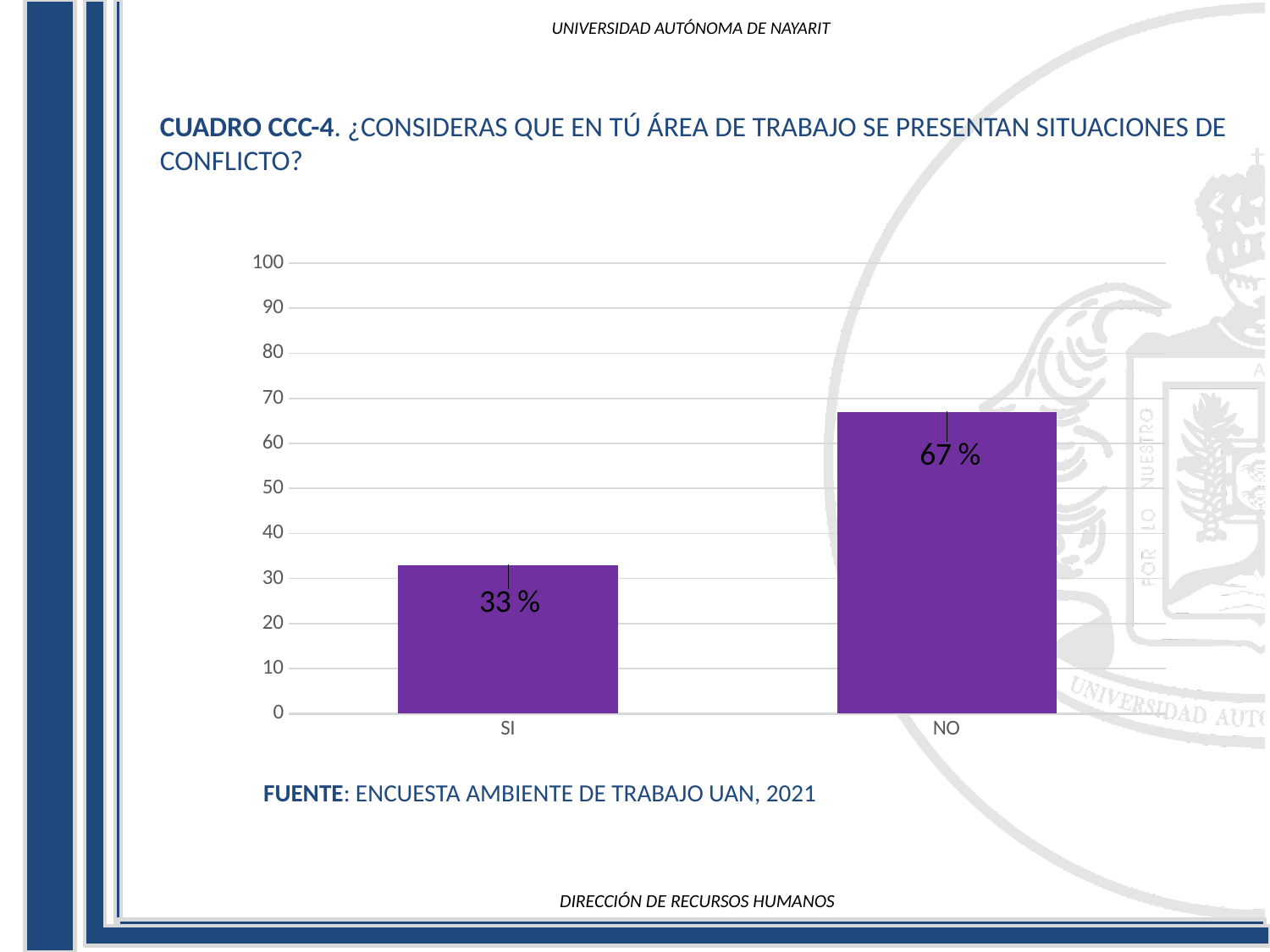
What is the value for SI? 33 % What source is cited below the chart? ENCUESTA AMBIENTE DE TRABAJO UAN, 2021 Which category has the highest value? NO What is the value for NO? 67 % What is the maximum value shown on the y axis? 100 How many categories are shown on the x axis? 2 Which is larger, the value for SI or the value for NO? NO What kind of chart is shown on the slide? bar chart Which category has the lowest value? SI What is the difference between the values for NO and SI? 34 % Is the value for NO greater or less than 50? greater Is the value for SI greater or less than 40? less